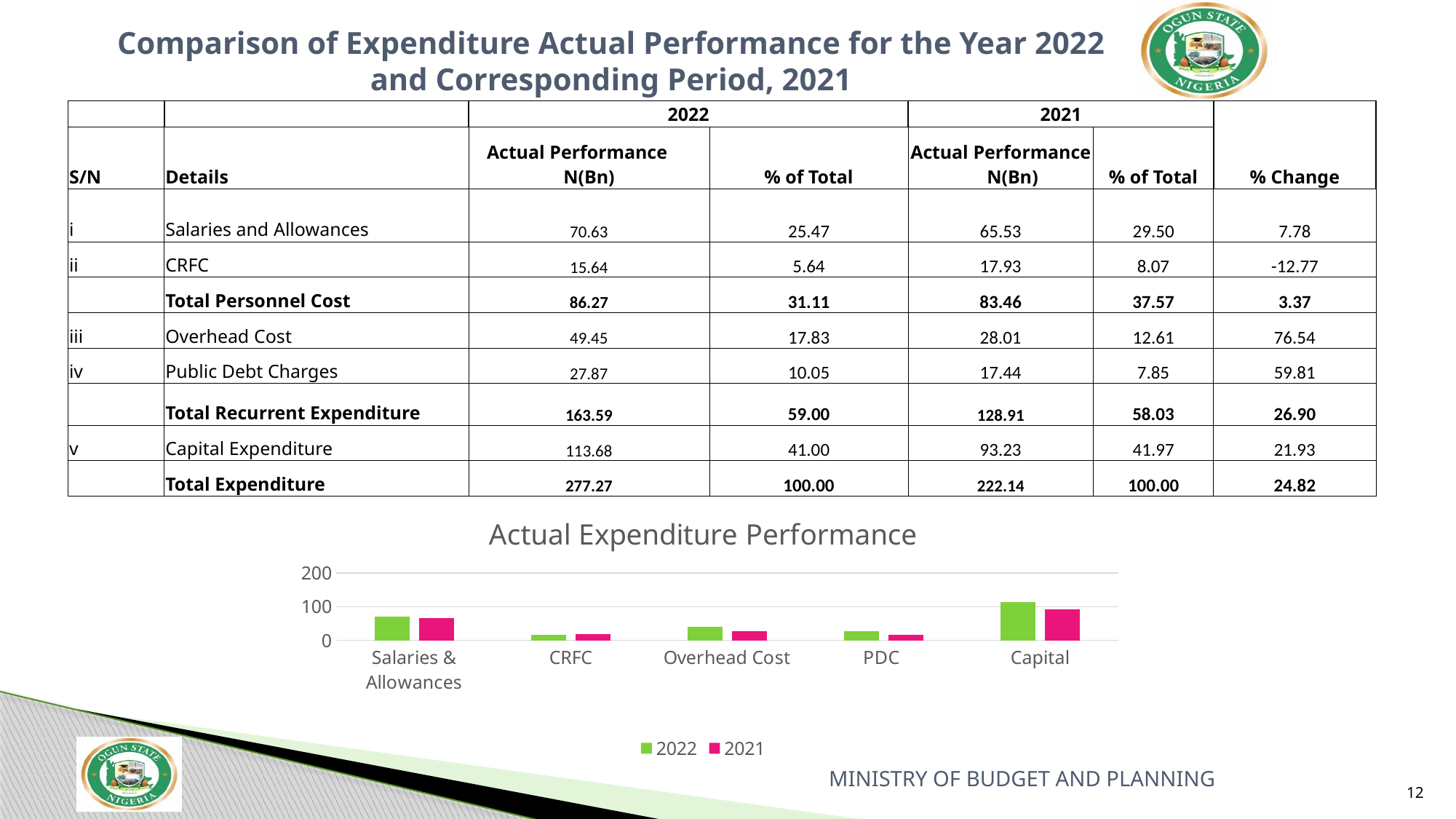
In the 'Actual Expenditure Performance' chart, which category has the highest 2022 bar? Capital In the 'Actual Expenditure Performance' chart, is the 2022 value for Capital greater or less than 100? greater In the 'Actual Expenditure Performance' chart, is the 2021 value for Capital greater or less than 100? less In the 'Actual Expenditure Performance' chart, is the 2022 value for Salaries & Allowances greater or less than 100? less In the 'Actual Expenditure Performance' chart, which is larger for PDC: the 2022 bar or the 2021 bar? 2022 How many categories are shown on the x axis of the 'Actual Expenditure Performance' chart? 5 What kind of chart is shown under the title 'Actual Expenditure Performance'? bar chart In the 'Actual Expenditure Performance' chart, which colour represents the 2021 series? pink In the 'Actual Expenditure Performance' chart, which is larger for Overhead Cost: the 2022 bar or the 2021 bar? 2022 How many series does the legend of the 'Actual Expenditure Performance' chart list? 2 In the 'Actual Expenditure Performance' chart, which category has the lowest 2022 bar? CRFC In the 'Actual Expenditure Performance' chart, which category has the highest 2021 bar? Capital